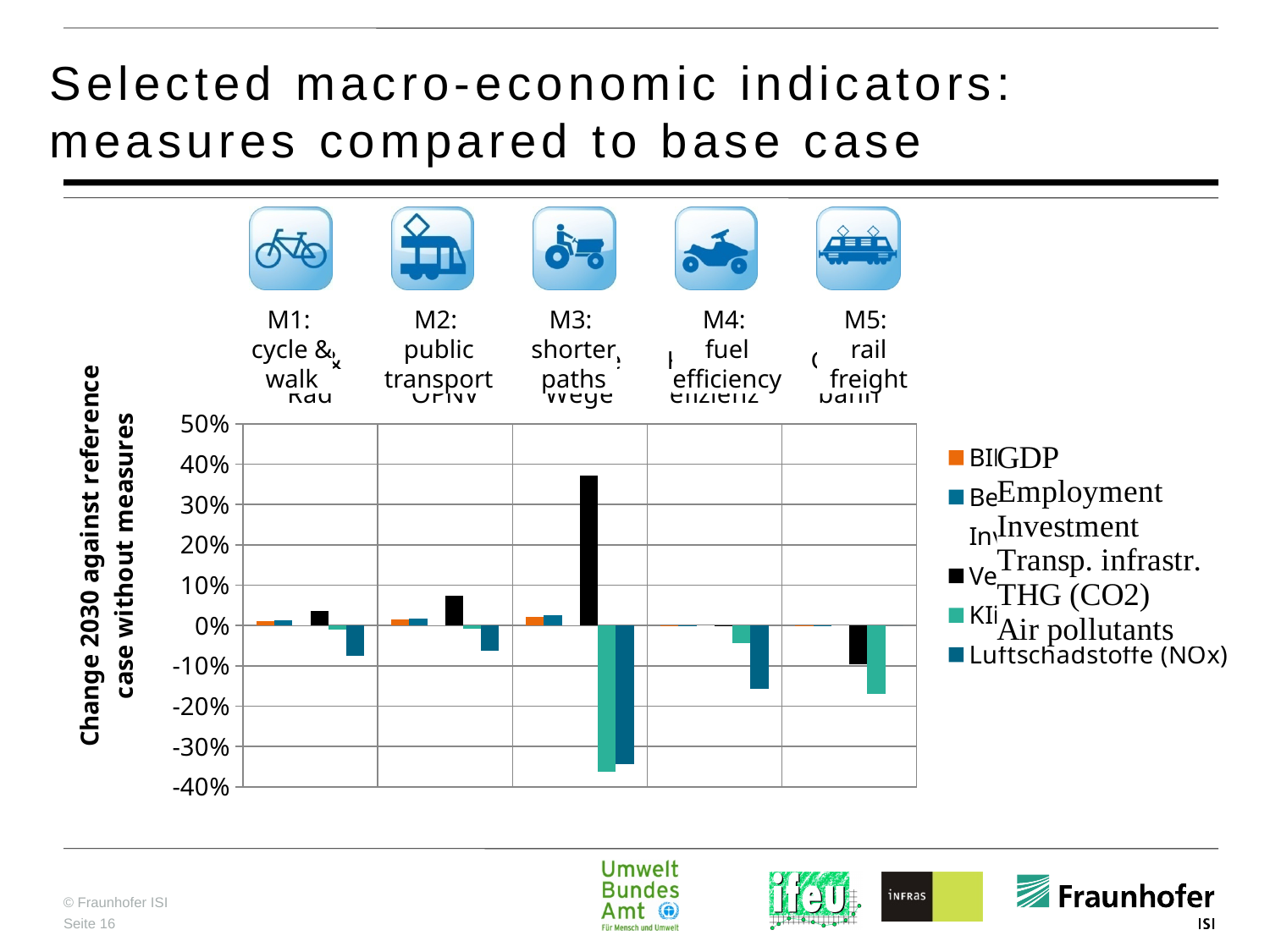
How many measures (categories) are plotted along the x axis of the chart? 5 What colour are the Transp. infrastr. bars in the chart? black Which measure has the highest Transp. infrastr. value in the chart? M3: shorter paths Is the Transp. infrastr. value for M5: rail freight greater or less than 0%? less Which has the lower THG (CO2) value, M4: fuel efficiency or M5: rail freight? M5: rail freight Is the Transp. infrastr. value for M3: shorter paths greater or less than 30%? greater Is the THG (CO2) value for M5: rail freight greater or less than -10%? less What is the title of the vertical axis of the chart? Change 2030 against reference case without measures Which has the larger Transp. infrastr. value, M1: cycle & walk or M2: public transport? M2: public transport What kind of chart is shown on the slide? bar chart Which measure has the lowest THG (CO2) value in the chart? M3: shorter paths